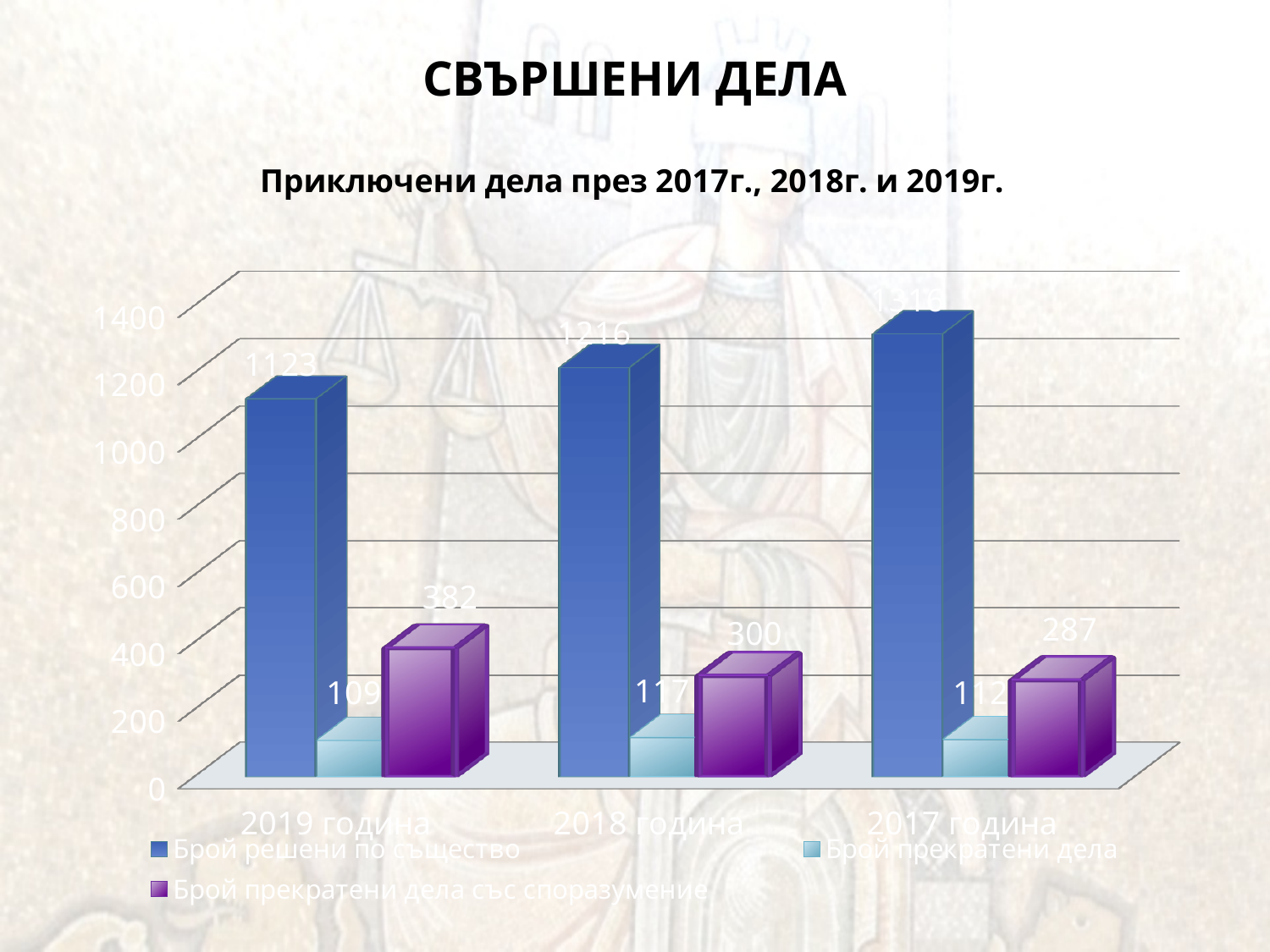
What is the value of 'Брой решени по същество' for 2019 година? 1123 What is the value of 'Брой прекратени дела със споразумение' for 2017 година? 287 What is the value of 'Брой прекратени дела със споразумение' for 2019 година? 382 Which year has the lowest value for 'Брой прекратени дела'? 2019 година What type of chart is shown on the slide? bar chart How many year categories are shown on the x axis? 3 Is the value of 'Брой решени по същество' for 2017 година greater or less than 1200? greater What is the difference between 'Брой прекратени дела със споразумение' for 2019 година and 2018 година? 82 How many series does the legend list? 3 What is the value of 'Брой решени по същество' for 2018 година? 1216 What is the value of 'Брой прекратени дела' for 2018 година? 117 Which year has the highest value for 'Брой прекратени дела със споразумение'? 2019 година